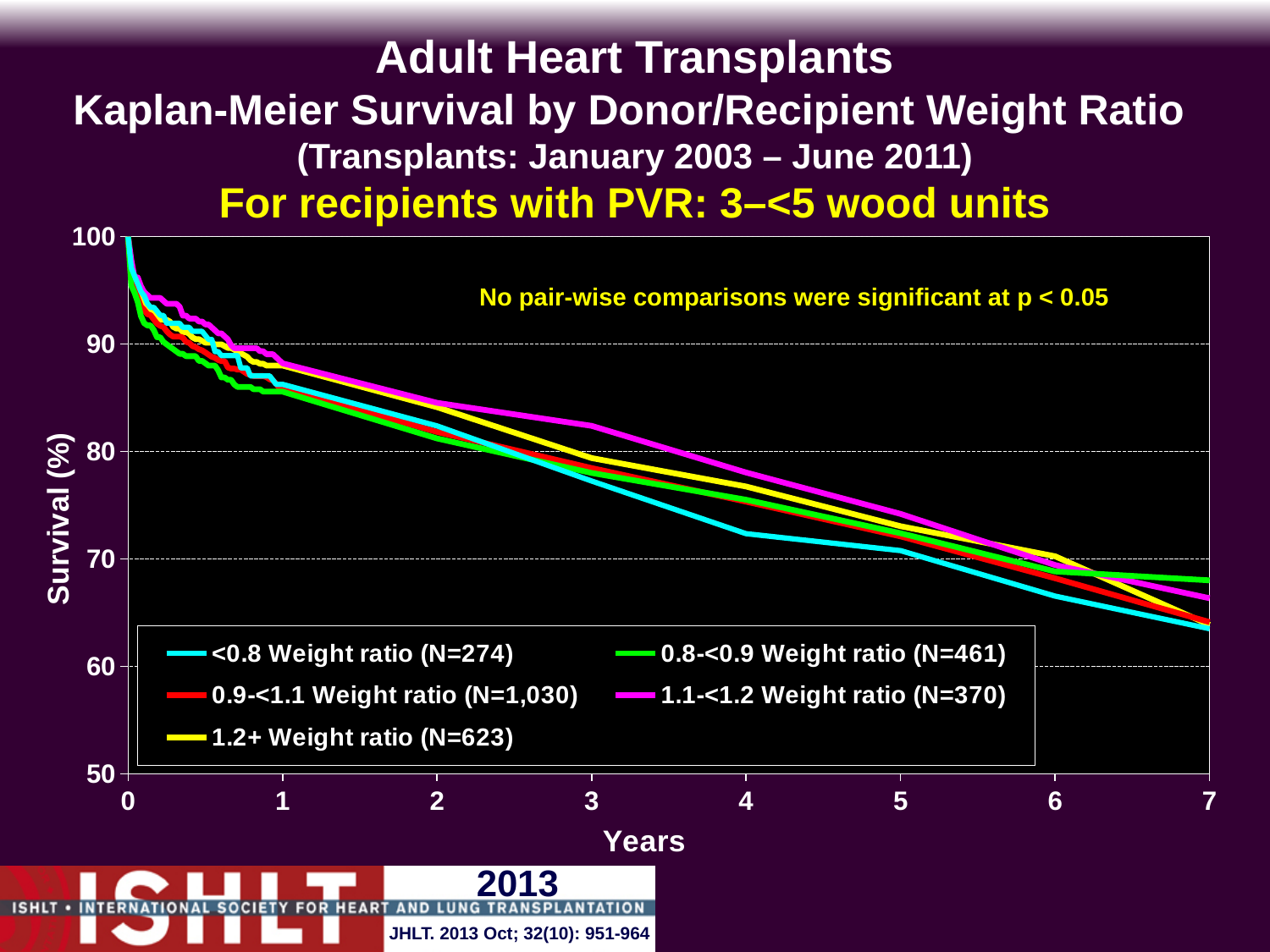
Is the survival value for the <0.8 Weight ratio group at 4 years greater or less than 70? greater What is the label of the y axis? Survival (%) Is the survival value for the 0.8-<0.9 Weight ratio group at 7 years greater or less than 70? less What is the N for the 1.2+ Weight ratio group shown in the legend? N=623 What does the annotation on the chart say about pair-wise comparisons? No pair-wise comparisons were significant at p < 0.05 Is the survival value for the 1.1-<1.2 Weight ratio group at 3 years greater or less than 80? greater What is the N for the 0.9-<1.1 Weight ratio group shown in the legend? N=1,030 Do the survival curves rise or fall as years increase? Fall What kind of chart is shown on the slide? Line chart Which weight ratio group has the highest survival at 3 years? 1.1-<1.2 Weight ratio How many series does the legend list? 5 Which weight ratio group has the lowest survival at 4 years? <0.8 Weight ratio